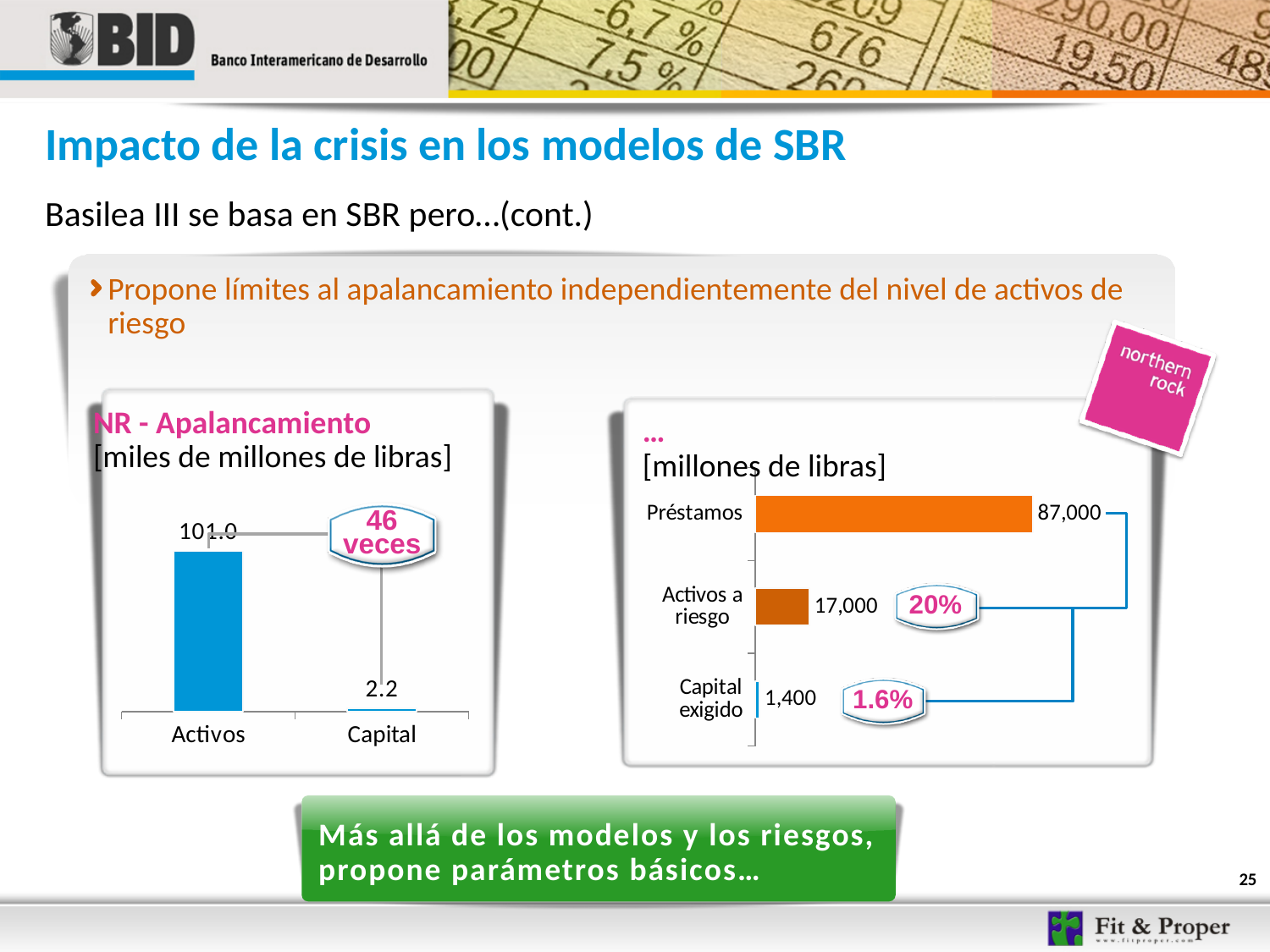
In the left chart (NR - Apalancamiento), how many categories are shown? 2 In the right chart (millones de libras), what is the difference between Préstamos and Activos a riesgo? 70,000 In the right chart (millones de libras), what is the value for Capital exigido? 1,400 In the left chart (NR - Apalancamiento), what is the value for Capital? 2.2 In the right chart (millones de libras), how many categories are shown? 3 In the right chart (millones de libras), which category has the highest value? Préstamos In the right chart (millones de libras), what is the value for Activos a riesgo? 17,000 In the right chart (millones de libras), what is the value for Préstamos? 87,000 In the left chart (NR - Apalancamiento), what is the difference between Activos and Capital? 98.8 What kind of chart is the left chart (NR - Apalancamiento)? Bar chart In the right chart (millones de libras), which category has the lowest value? Capital exigido In the left chart (NR - Apalancamiento), what is the value for Activos? 101.0